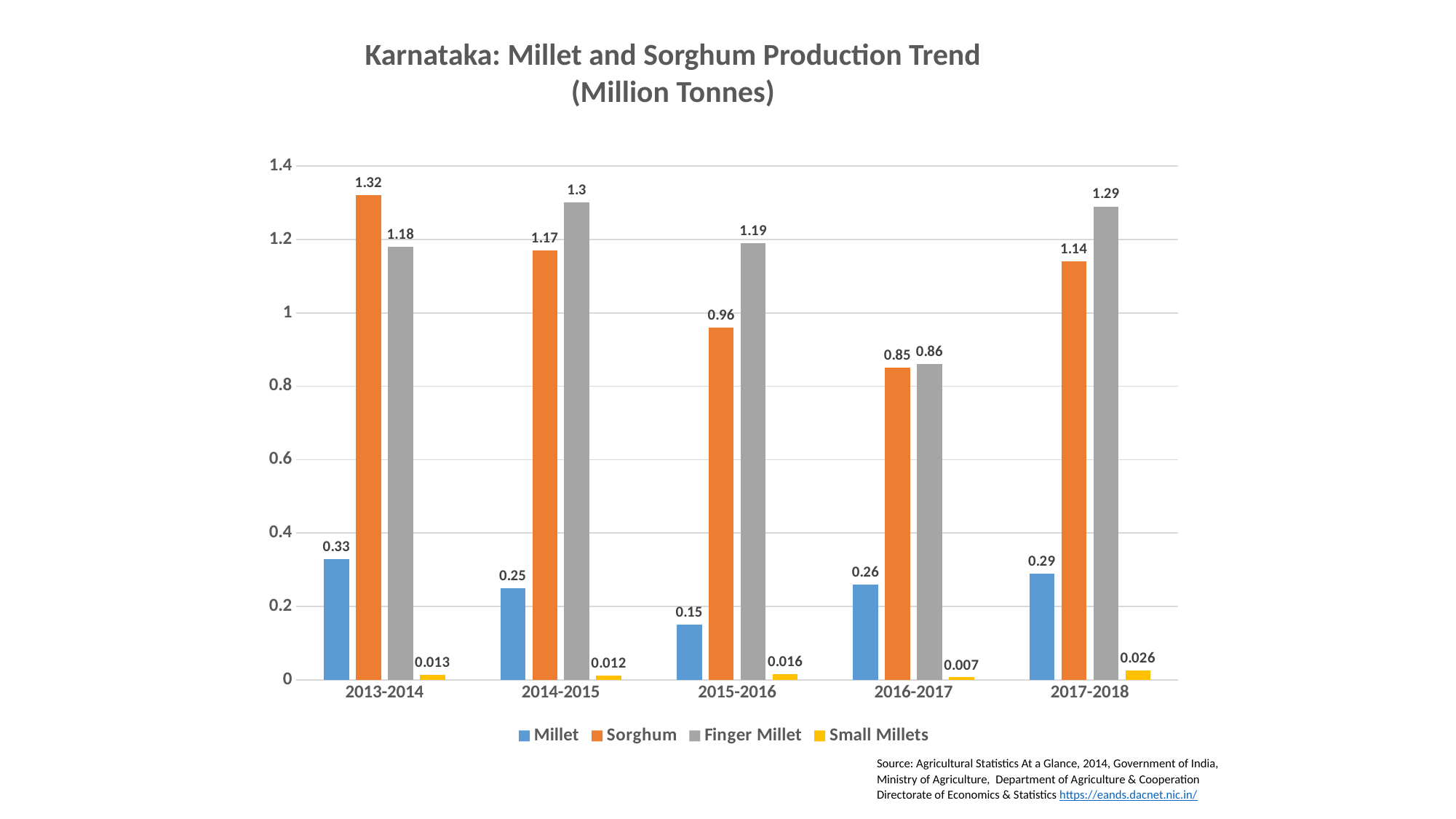
How many years are shown on the x axis? 5 What was the Sorghum production in 2013-2014? 1.32 Did Sorghum production rise or fall from 2013-2014 to 2016-2017? Fall How many series does the legend list? 4 In which year was Sorghum production highest? 2013-2014 What kind of chart is shown on the slide? Bar chart What is the difference between Finger Millet and Sorghum production in 2015-2016? 0.23 Which was larger in 2014-2015, Sorghum or Finger Millet production? Finger Millet What was the Finger Millet production in 2017-2018? 1.29 In which year was Millet production lowest? 2015-2016 What unit is given in the chart title? Million Tonnes What was the Small Millets production in 2016-2017? 0.007